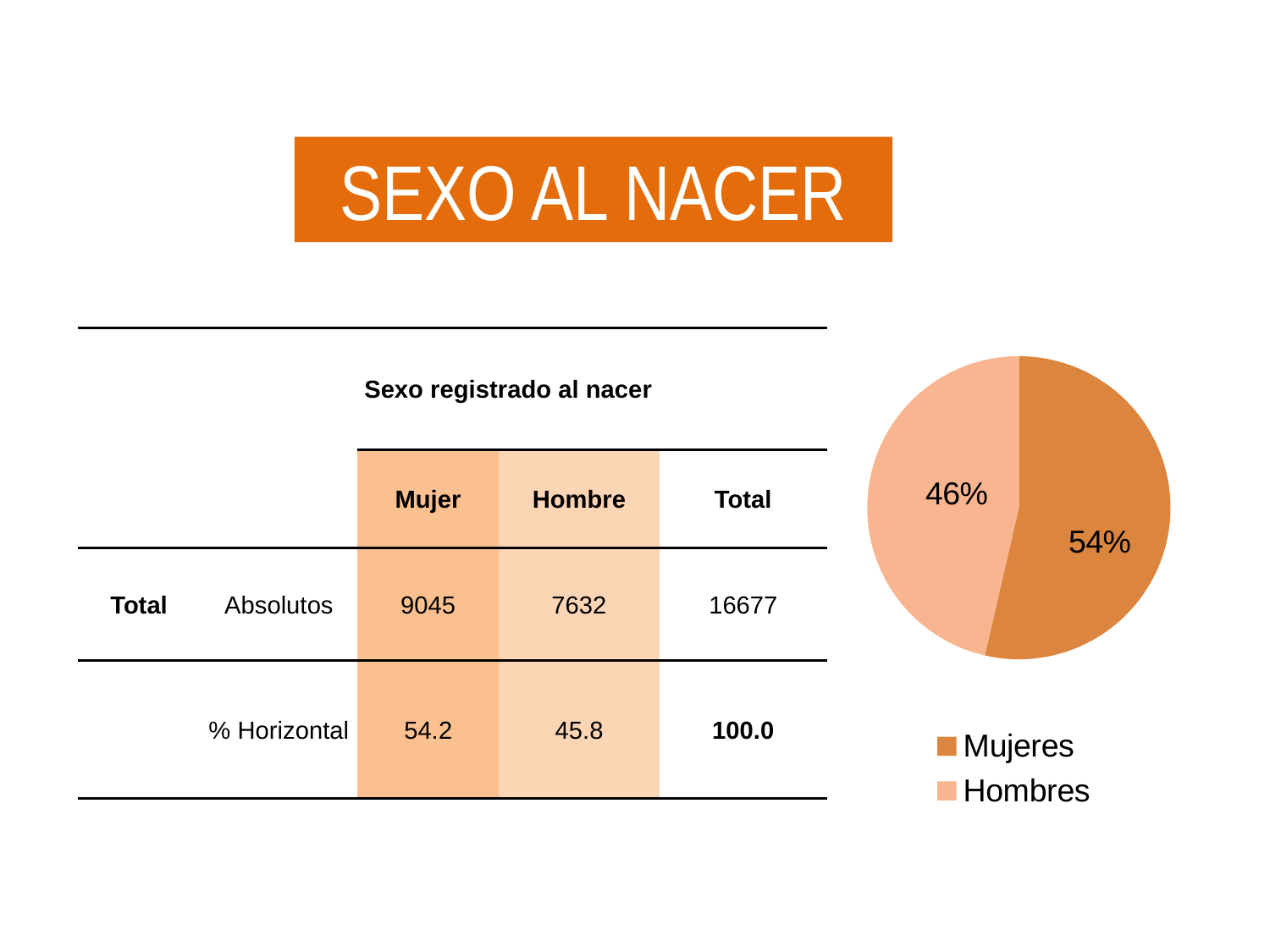
Which legend entry of the pie chart is shown in the darker orange colour? Mujeres What is the difference in percentage points between the Mujeres and Hombres slices of the pie chart? 8% Is the Hombres slice of the pie chart greater or less than 50%? less Which slice of the pie chart is the smallest? Hombres What share of the pie chart is labelled for Mujeres? 54% Which is larger in the pie chart, Mujeres or Hombres? Mujeres What kind of chart is shown on the slide? pie chart How many entries does the pie chart legend list? 2 What share of the pie chart is labelled for Hombres? 46% Which slice of the pie chart is the largest? Mujeres How many slices does the pie chart have? 2